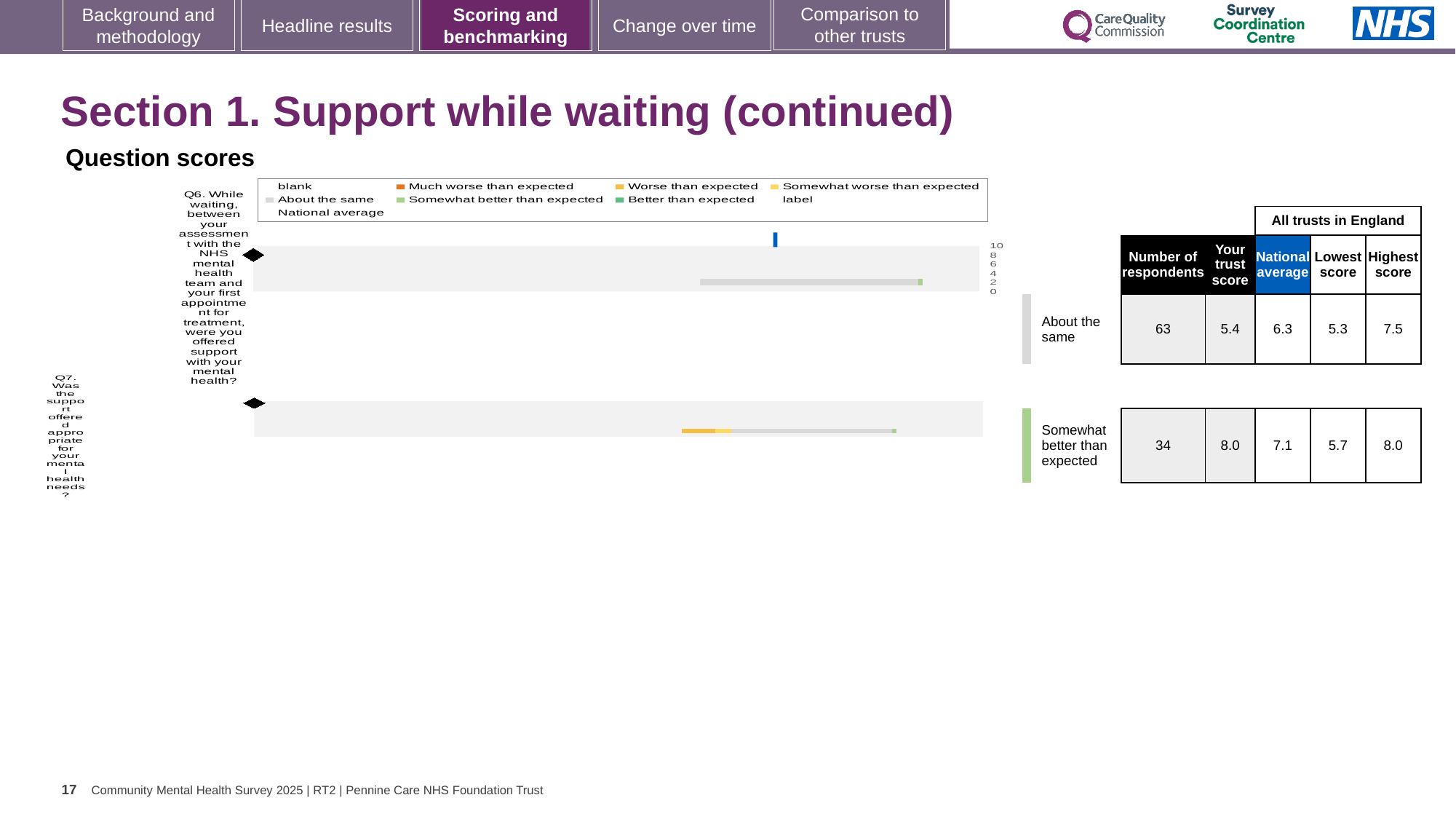
What is the highest value shown on the chart's score axis? 10 Which is larger for Q7: the trust score or the national average? trust score What kind of chart is shown under 'Question scores'? bar chart What benchmark category is shown for Q6 (support while waiting)? About the same What is the national average score for Q6? 6.3 What is the difference between the trust score and the national average for Q6? 0.9 What is the number of respondents for Q6? 63 What benchmark category is shown for Q7 (was the support appropriate)? Somewhat better than expected What is the trust score for Q7? 8.0 How many questions (categories) are plotted in the Question scores chart? 2 How many more respondents answered Q6 than Q7? 29 What is the highest score among all trusts in England for Q7? 8.0